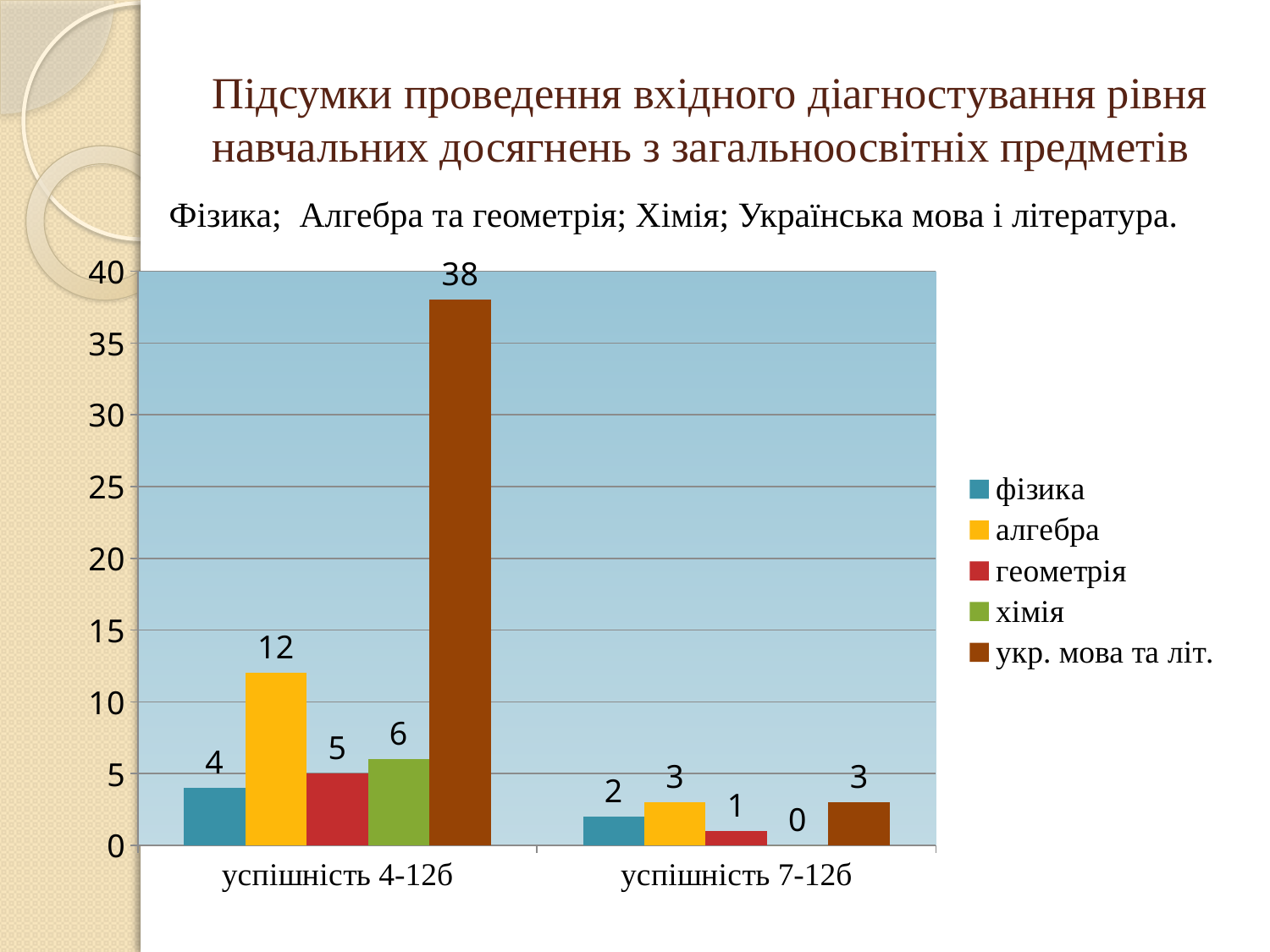
What is the value for укр. мова та літ. in the успішність 4-12б category? 38 What kind of chart is shown on the slide? bar chart How many categories are shown on the x axis? 2 How many series does the legend list? 5 What is the value for геометрія in the успішність 7-12б category? 1 What is the difference between the укр. мова та літ. value and the алгебра value in the успішність 4-12б category? 26 What colour represents алгебра in the chart? yellow Which is larger in the успішність 4-12б category: the value for хімія or the value for геометрія? хімія Which series has the highest value in the успішність 4-12б category? укр. мова та літ. Which series has the lowest value in the успішність 7-12б category? хімія What is the value for алгебра in the успішність 4-12б category? 12 What is the value for хімія in the успішність 7-12б category? 0